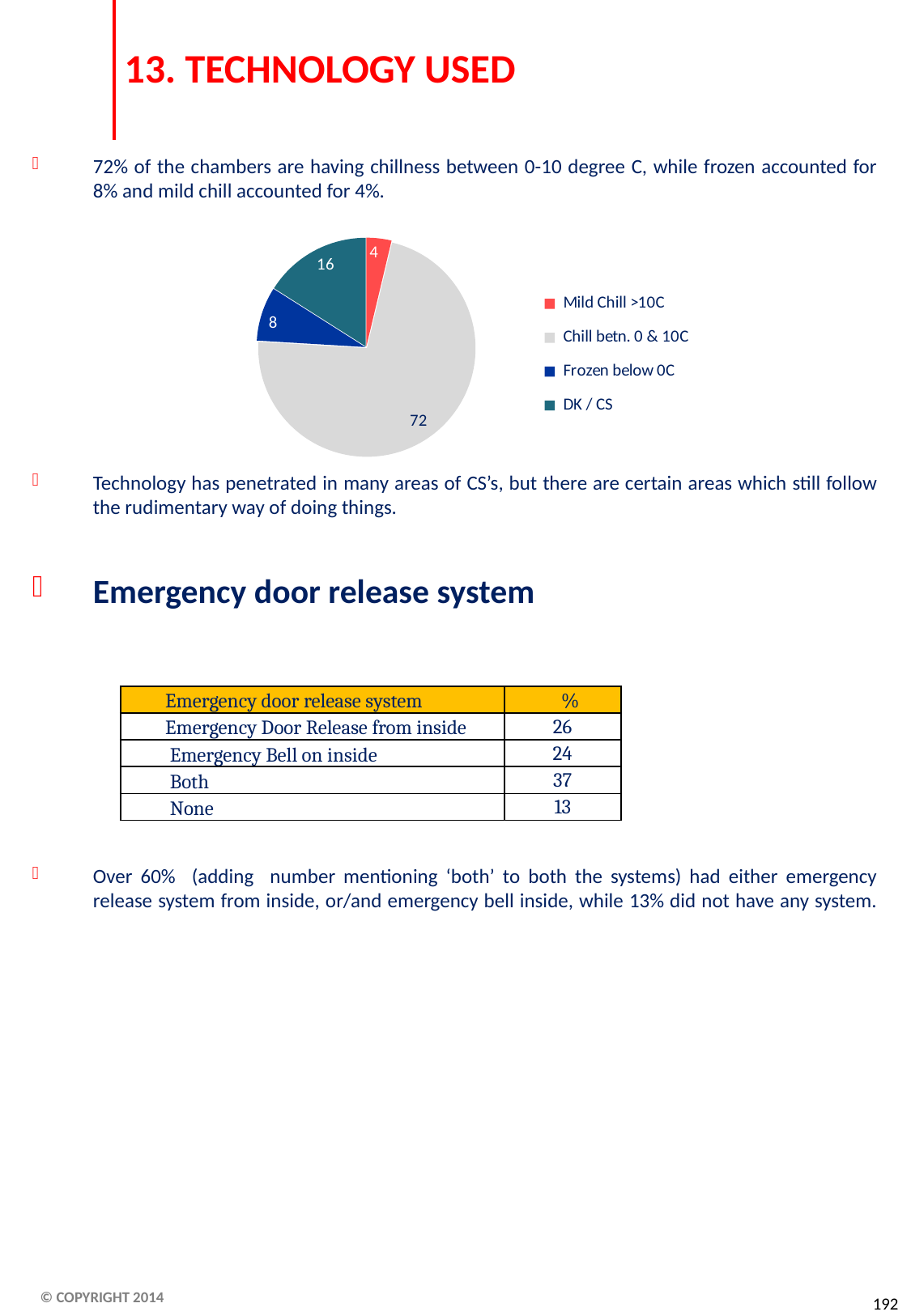
What colour is the Chill betn. 0 & 10C slice in the pie chart? Light grey Which category has the smallest slice in the pie chart? Mild Chill >10C What value is shown for the Mild Chill >10C slice of the pie chart? 4 What type of chart is shown on the slide? Pie chart What value is shown for the Frozen below 0C slice of the pie chart? 8 What value is shown for the DK / CS slice of the pie chart? 16 What value is shown for the Chill betn. 0 & 10C slice of the pie chart? 72 In the pie chart, which is larger: Frozen below 0C or DK / CS? DK / CS Which category has the largest slice in the pie chart? Chill betn. 0 & 10C How many entries does the pie chart's legend list? 4 What is the difference between the DK / CS value and the Frozen below 0C value in the pie chart? 8 How many slices does the pie chart have? 4